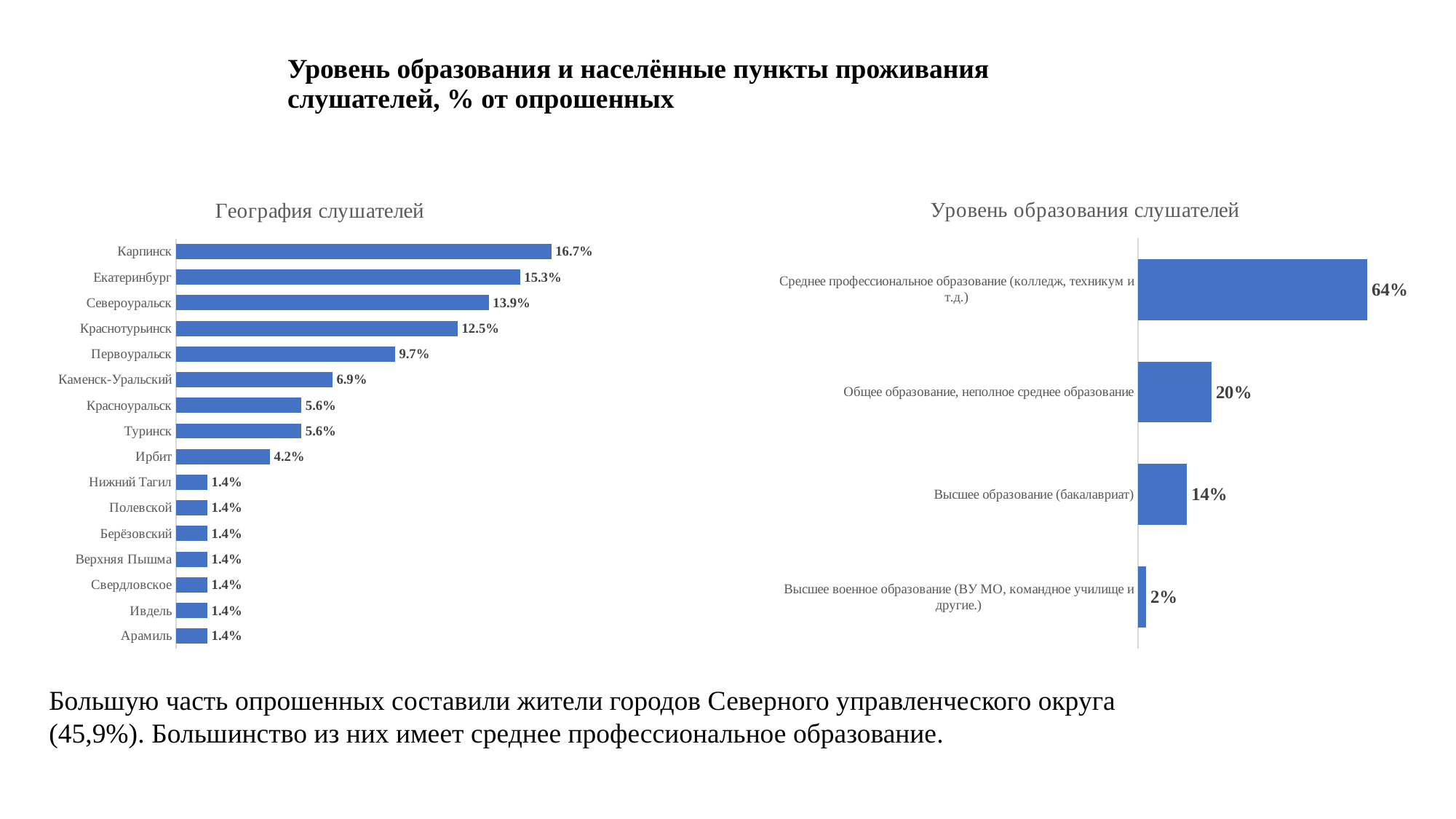
In the 'География слушателей' chart, what is the value for Ирбит? 4.2% In the 'География слушателей' chart, how many cities are listed? 16 In the 'Уровень образования слушателей' chart, how many categories are shown? 4 In the 'Уровень образования слушателей' chart, which category has the lowest value? Высшее военное образование (ВУ МО, командное училище и другие.) In the 'География слушателей' chart, which is larger: the value for Первоуральск or for Каменск-Уральский? Первоуральск In the 'Уровень образования слушателей' chart, what is the value for 'Высшее образование (бакалавриат)'? 14% In the 'Уровень образования слушателей' chart, what is the difference between the values for 'Среднее профессиональное образование' and 'Общее образование, неполное среднее образование'? 44% What is the title of the chart on the left side of the slide? География слушателей In the 'География слушателей' chart, which city has the highest value? Карпинск In the 'География слушателей' chart, what is the value for Екатеринбург? 15.3% In the 'География слушателей' chart, what is the difference between the values for Карпинск and Североуральск? 2.8% What type of chart is the 'Уровень образования слушателей' chart? Bar chart